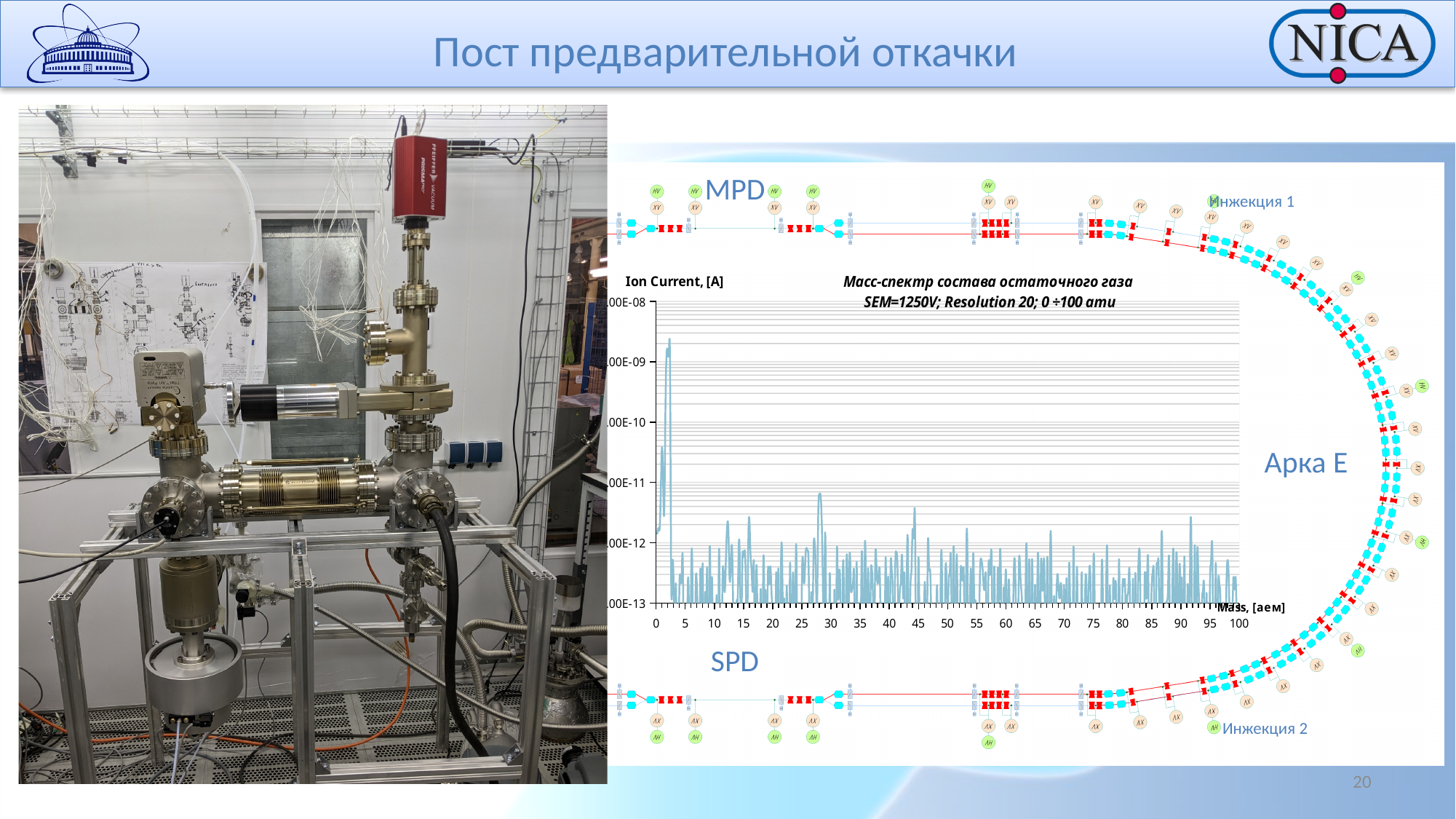
Is the ion current of the tallest peak in the mass spectrum greater or less than 1.00E-08? less Is the ion current of the peak near mass 28 greater or less than 1.00E-11? less What is the title of the chart on the slide? Масс-спектр состава остаточного газа SEM=1250V; Resolution 20; 0 ÷100 amu What is the lowest value shown on the vertical axis of the mass spectrum chart? 1.00E-13 What is the label of the vertical axis of the mass spectrum chart? Ion Current, [A] What kind of chart is the mass spectrum on the slide? line chart What is the highest value shown on the vertical axis of the mass spectrum chart? 1.00E-08 How many tick labels are printed along the horizontal (mass) axis of the chart? 21 Which is larger in the mass spectrum: the peak near mass 2 or the peak near mass 28? the peak near mass 2 Is the ion current of the peak near mass 28 greater or less than 1.00E-10? less What is the largest mass value labelled on the horizontal axis of the mass spectrum chart? 100